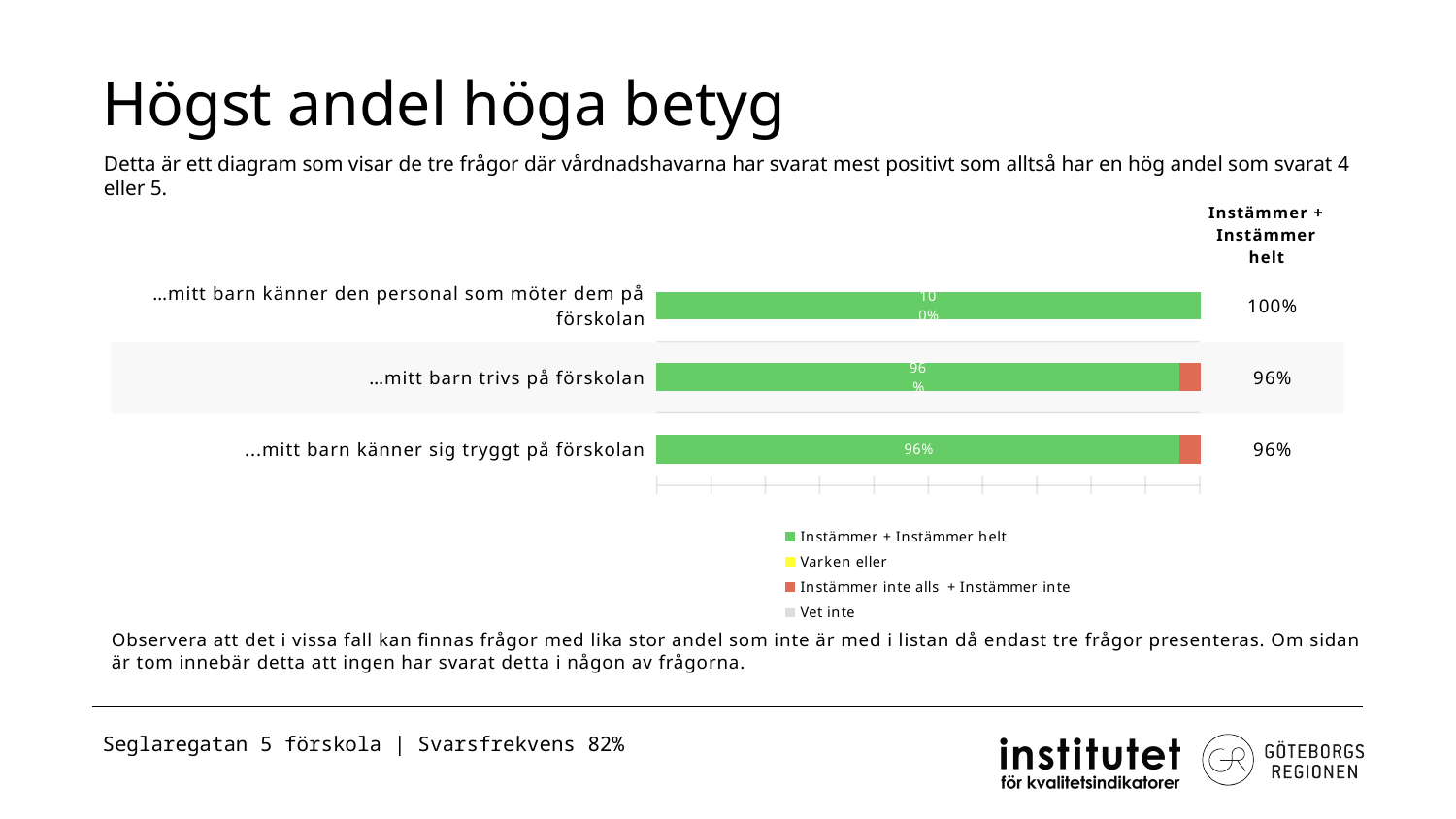
What is the response rate (Svarsfrekvens) shown at the bottom of the slide? 82% What is the 'Instämmer + Instämmer helt' value for '…mitt barn känner den personal som möter dem på förskolan'? 100% What colour represents 'Instämmer + Instämmer helt' in the chart? green Which category has the highest 'Instämmer + Instämmer helt' share? …mitt barn känner den personal som möter dem på förskolan What is the 'Instämmer + Instämmer helt' value for '...mitt barn känner sig tryggt på förskolan'? 96% What kind of chart is shown on the slide? bar chart Which is larger: the 'Instämmer + Instämmer helt' share for '…mitt barn känner den personal som möter dem på förskolan' or for '...mitt barn känner sig tryggt på förskolan'? …mitt barn känner den personal som möter dem på förskolan How many series does the legend list? 4 What is the difference between the 'Instämmer + Instämmer helt' share for '…mitt barn känner den personal som möter dem på förskolan' and for '…mitt barn trivs på förskolan'? 4% What is the title of the slide containing the chart? Högst andel höga betyg How many categories (questions) are plotted in the chart? 3 What is the 'Instämmer + Instämmer helt' value for '…mitt barn trivs på förskolan'? 96%